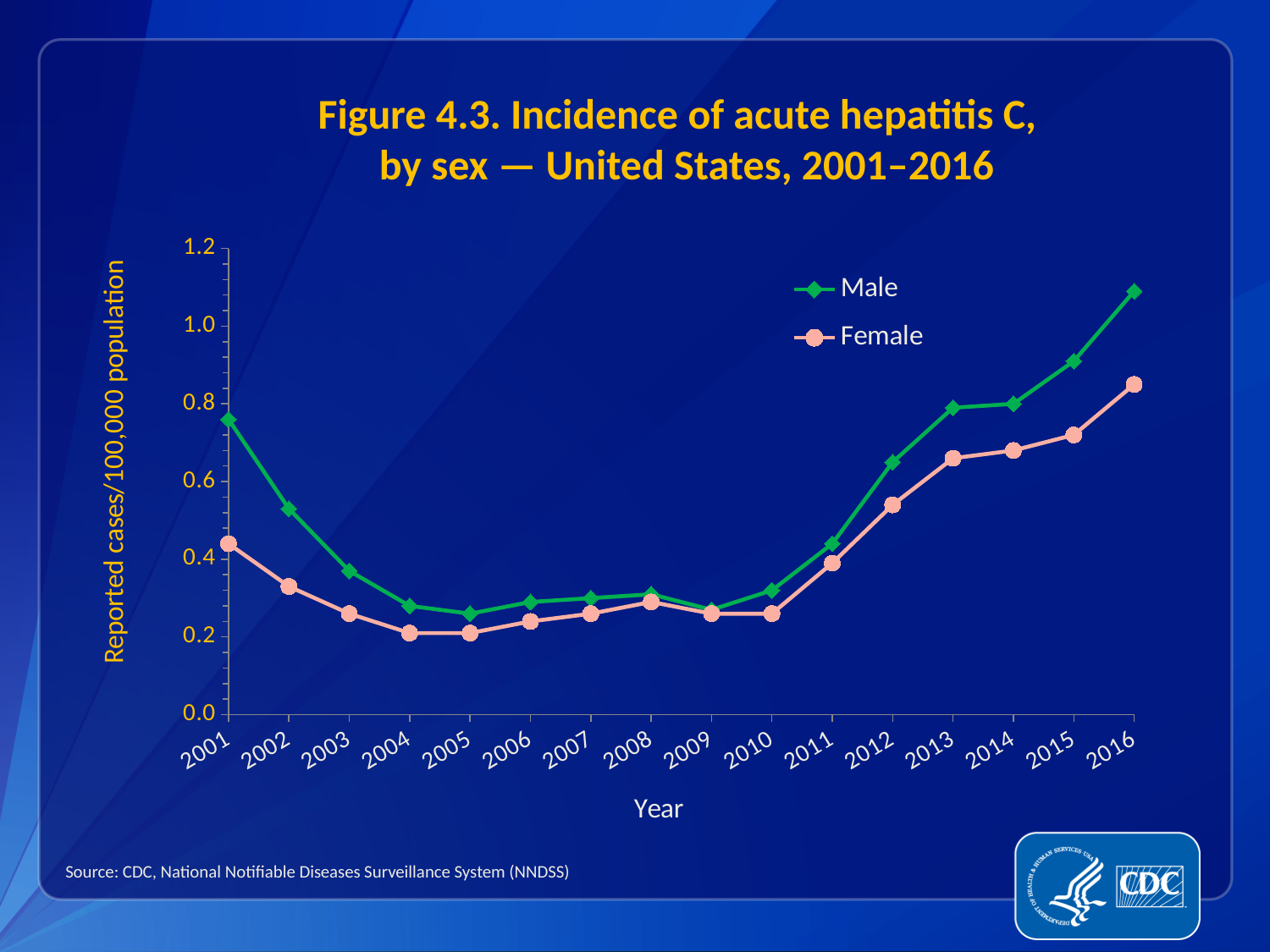
In which year is the Female incidence rate highest? 2016 What is the label of the y axis? Reported cases/100,000 population Is the Female value for 2012 greater or less than 0.6? less How many series does the legend list? 2 In which year is the Male incidence rate highest? 2016 Is the Female value for 2016 greater or less than 0.8? greater Which series has the higher value in 2016, Male or Female? Male Is the Male value for 2016 greater or less than 1.0? greater What kind of chart is shown on the slide? line chart How many years are plotted along the x axis? 16 Does the Male incidence rate rise or fall from 2001 to 2004? fall